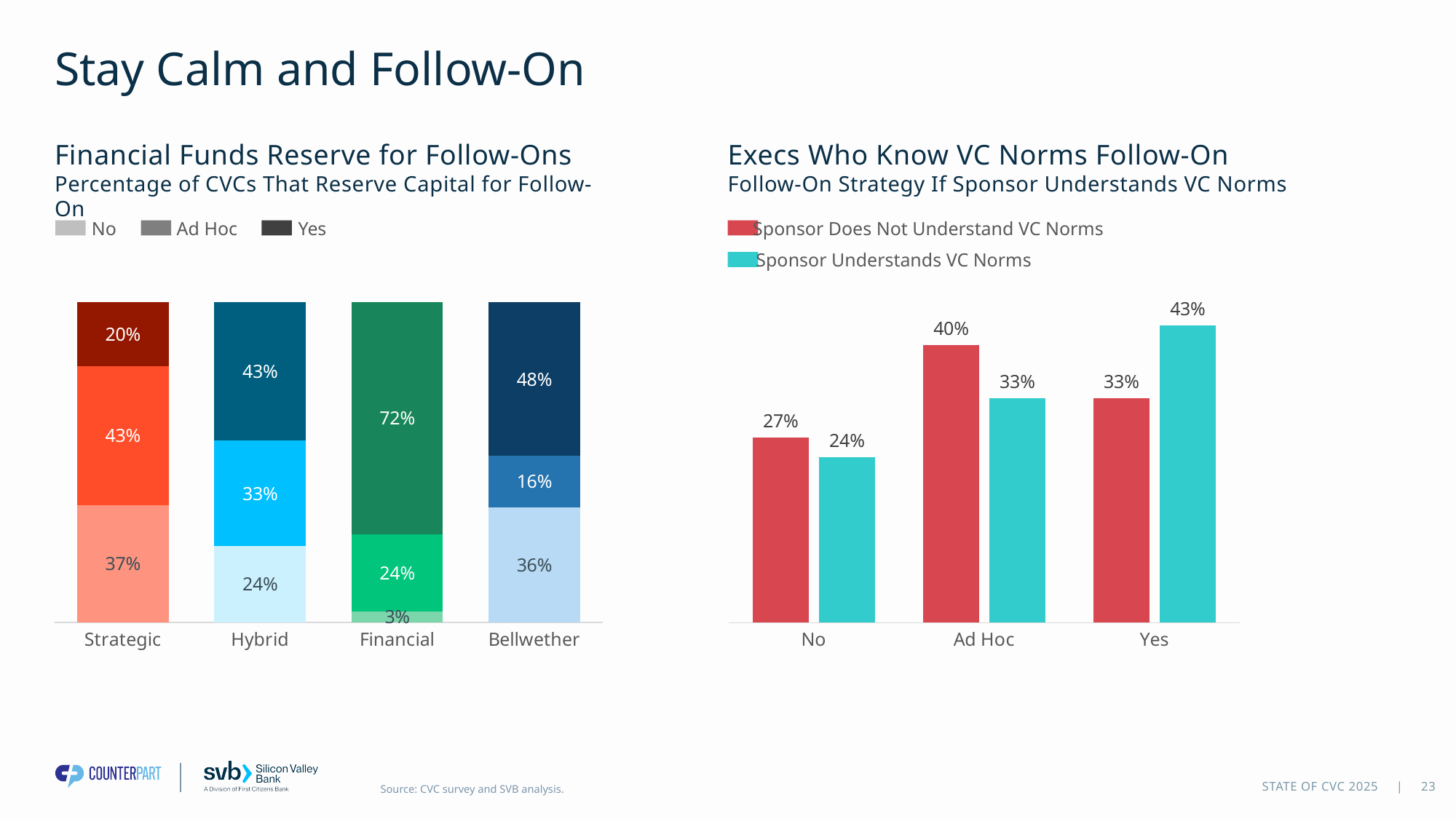
In the 'Execs Who Know VC Norms Follow-On' chart, what is the value for 'Sponsor Does Not Understand VC Norms' in the Ad Hoc category? 40% In the 'Execs Who Know VC Norms Follow-On' chart, which series has the larger value in the No category? Sponsor Does Not Understand VC Norms In the 'Financial Funds Reserve for Follow-Ons' chart, what is the value of the middle segment of the Bellwether bar? 16% In the 'Financial Funds Reserve for Follow-Ons' chart, what is the value of the top segment of the Financial bar? 72% In the 'Financial Funds Reserve for Follow-Ons' chart, how many categories are shown on the x axis? 4 In the 'Financial Funds Reserve for Follow-Ons' chart, how many entries does the legend list? 3 What kind of chart is 'Financial Funds Reserve for Follow-Ons'? Stacked bar chart In the 'Execs Who Know VC Norms Follow-On' chart, what is the difference between the two series in the Yes category? 10% In the 'Financial Funds Reserve for Follow-Ons' chart, what is the value of the bottom segment of the Strategic bar? 37% In the 'Financial Funds Reserve for Follow-Ons' chart, which category has the smallest bottom segment? Financial In the 'Execs Who Know VC Norms Follow-On' chart, what is the value for 'Sponsor Understands VC Norms' in the Yes category? 43% In the 'Execs Who Know VC Norms Follow-On' chart, which category has the highest value for 'Sponsor Does Not Understand VC Norms'? Ad Hoc